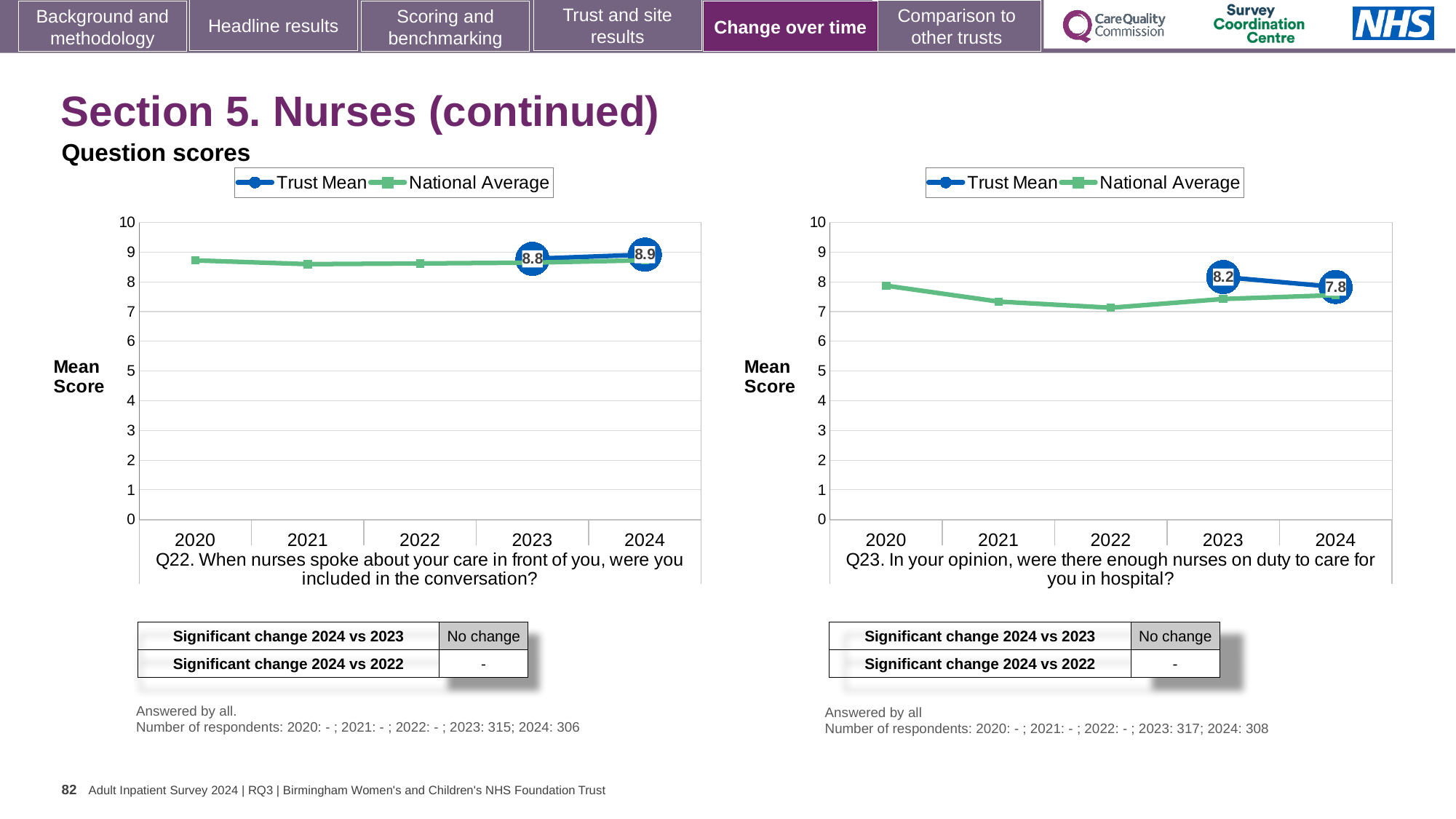
On the Q22 chart (left), is the National Average value for 2020 greater or less than 8? greater On the Q22 chart (left), what is the Trust Mean value for 2024? 8.9 On the Q23 chart (right), does the Trust Mean rise or fall from 2023 to 2024? fall On the Q23 chart (right), what is the difference between the Trust Mean values for 2023 and 2024? 0.4 What kind of chart is the Q23 chart (right)? line chart On the Q22 chart (left), what is the difference between the Trust Mean values for 2024 and 2023? 0.1 On the Q23 chart (right), is the National Average value for 2022 greater or less than 8? less On the Q23 chart (right), which year has the higher Trust Mean, 2023 or 2024? 2023 On the Q22 chart (left), what is the Trust Mean value for 2023? 8.8 How many series does the legend of the Q22 chart (left) list? 2 On the Q23 chart (right), what is the Trust Mean value for 2024? 7.8 On the Q23 chart (right), what is the Trust Mean value for 2023? 8.2